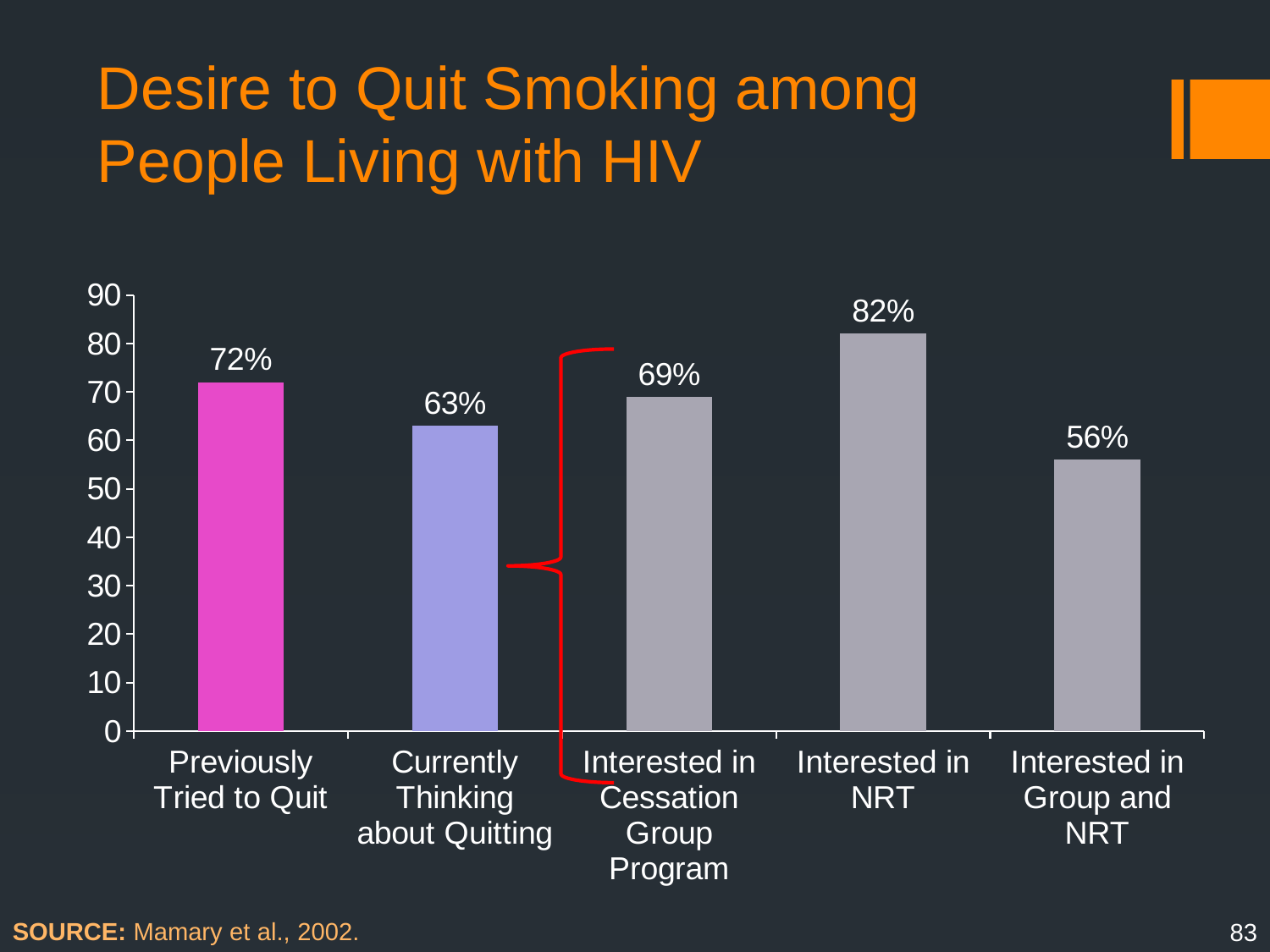
Which category has the highest value? Interested in NRT Which category has the lowest value? Interested in Group and NRT What is the value for Previously Tried to Quit? 72% Which is larger, the value for Previously Tried to Quit or the value for Interested in Cessation Group Program? Previously Tried to Quit What is the value for Interested in Cessation Group Program? 69% What is the value for Interested in Group and NRT? 56% How many categories are shown in the chart? 5 What is the source cited for the chart? Mamary et al., 2002. What kind of chart is shown on the slide? Bar chart What is the difference between the values for Interested in NRT and Interested in Group and NRT? 26% What is the title of the slide? Desire to Quit Smoking among People Living with HIV What is the value for Currently Thinking about Quitting? 63%